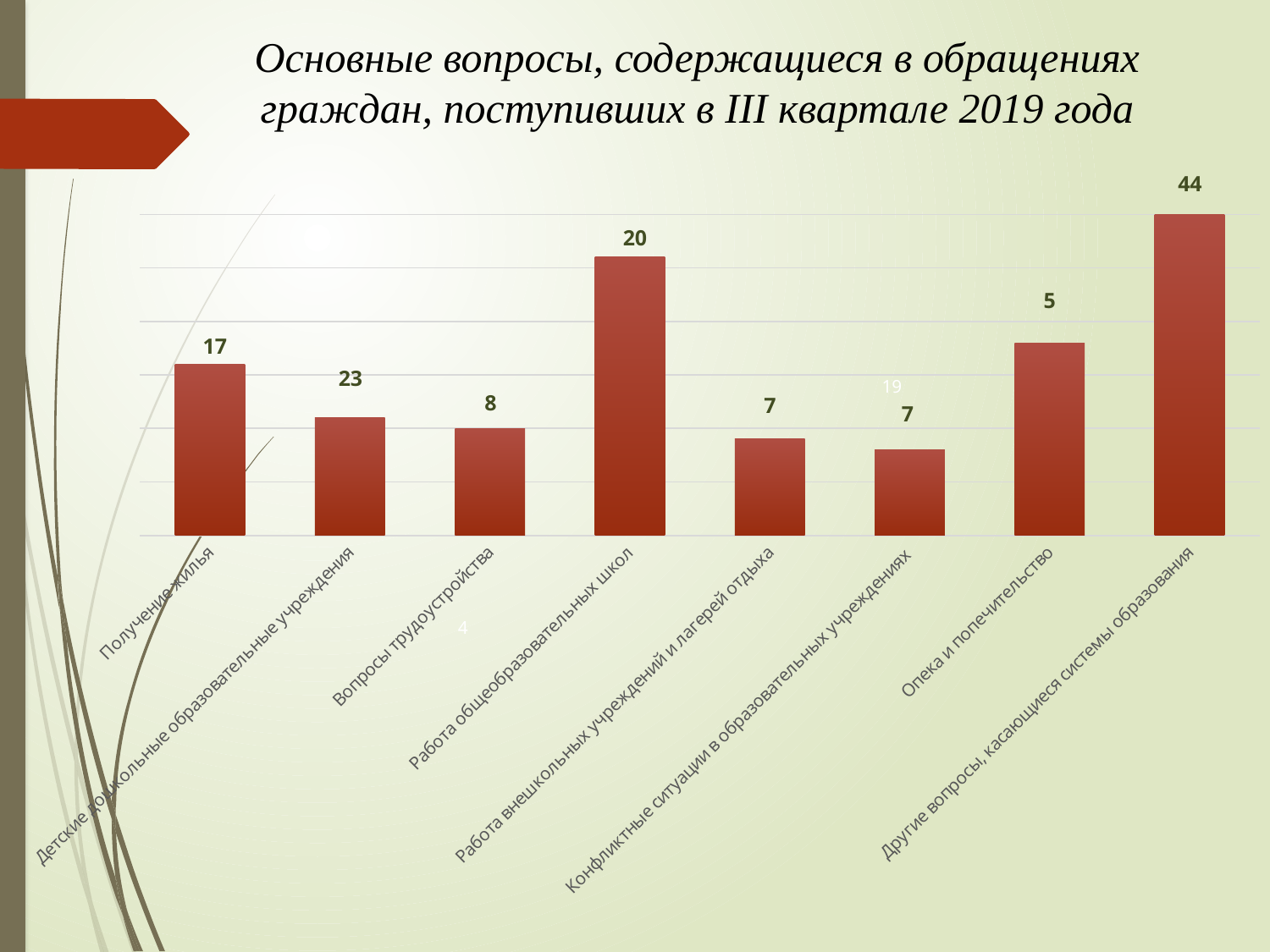
How many categories are shown in the chart? 8 What type of chart is shown on the slide? bar chart What is the title of the chart on the slide? Основные вопросы, содержащиеся в обращениях граждан, поступивших в III квартале 2019 года What is the value for "Работа общеобразовательных школ"? 20 Which is larger: the value for "Работа общеобразовательных школ" or the value for "Вопросы трудоустройства"? Работа общеобразовательных школ Which category has the highest value? Другие вопросы, касающиеся системы образования What is the value for "Работа внешкольных учреждений и лагерей отдыха"? 7 What is the difference between the values for "Другие вопросы, касающиеся системы образования" and "Работа общеобразовательных школ"? 24 What is the value for "Опека и попечительство"? 5 What is the value for "Получение жилья"? 17 What is the value for "Вопросы трудоустройства"? 8 What is the value for "Другие вопросы, касающиеся системы образования"? 44